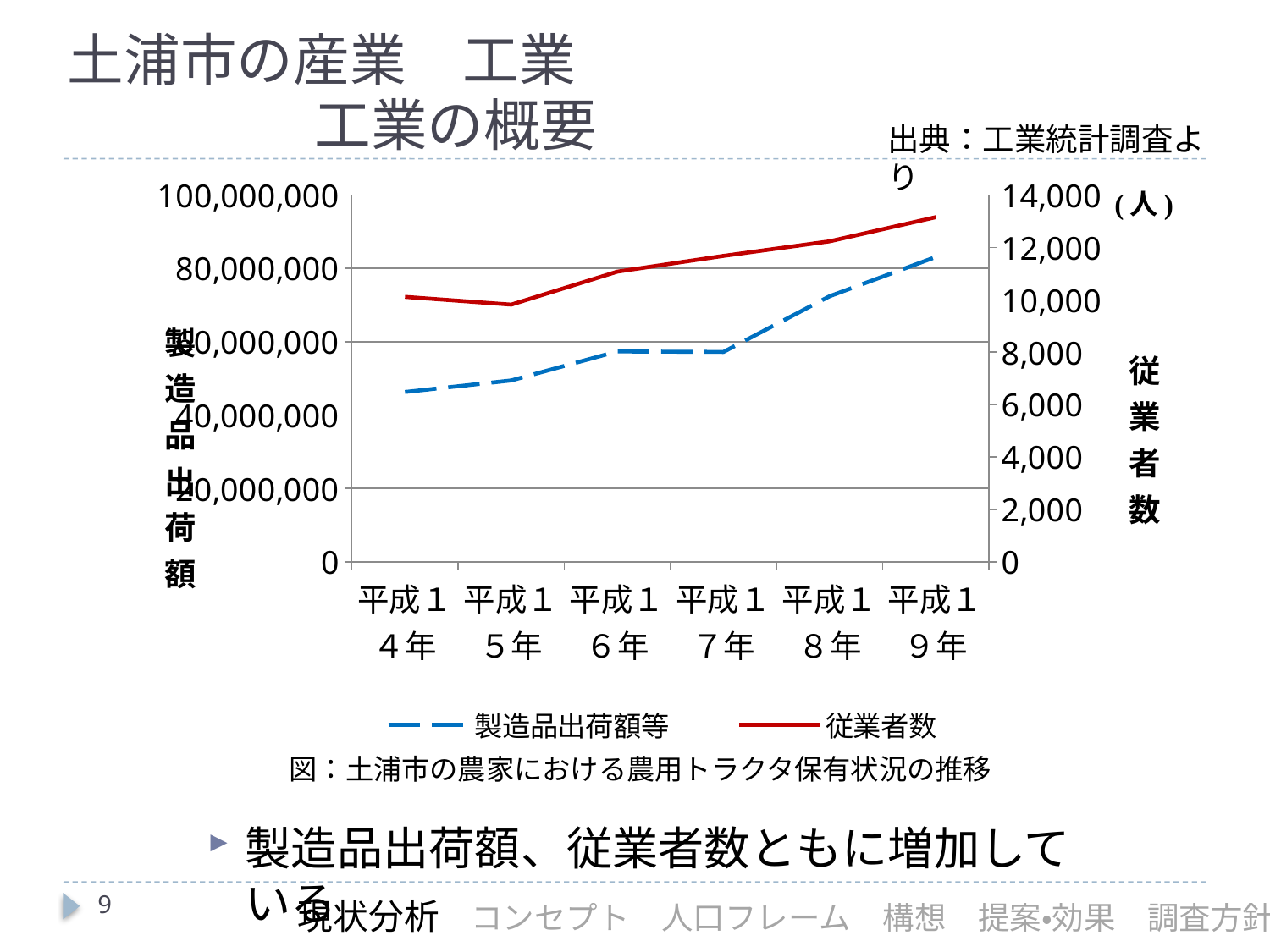
Does the 製造品出荷額等 series rise or fall from 平成14年 to 平成19年? rise Is the value for 製造品出荷額等 in 平成14年 greater or less than 60,000,000? less Is the value for 従業者数 in 平成19年 greater or less than 12,000? greater What unit is shown next to the right-hand axis of the chart? (人) How many years are plotted along the x axis of the chart? 6 In which year is 製造品出荷額等 lowest? 平成14年 Is the value for 製造品出荷額等 in 平成19年 greater or less than 80,000,000? greater How many series does the chart legend list? 2 Which series is drawn as a dashed blue line in the chart? 製造品出荷額等 Does the 従業者数 series rise or fall overall from 平成14年 to 平成19年? rise What kind of chart is shown on the slide? line chart In which year is 製造品出荷額等 highest? 平成19年